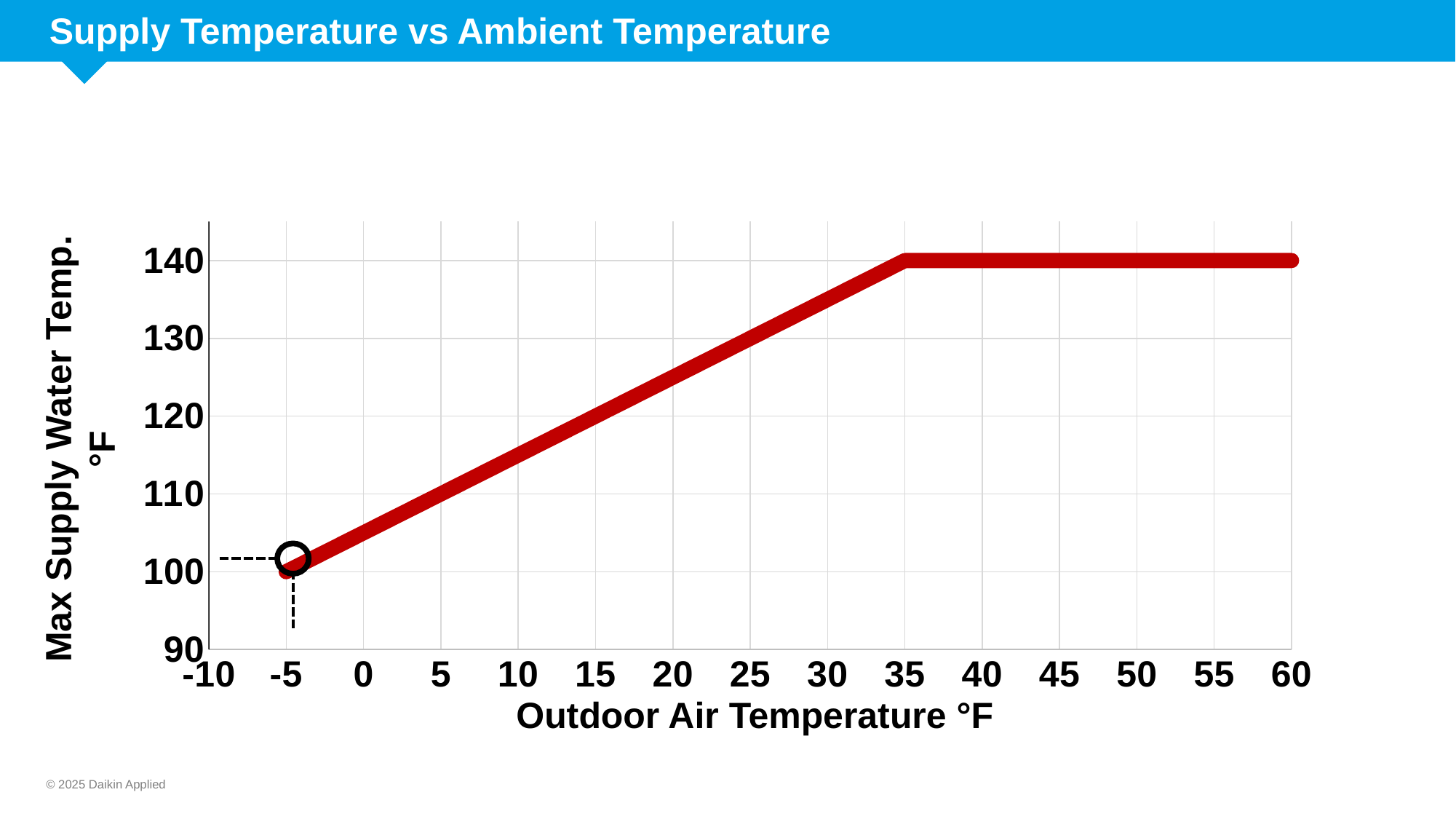
Is the Max Supply Water Temp. at an Outdoor Air Temperature of 5 °F greater or less than 120? less What is the Max Supply Water Temp. at an Outdoor Air Temperature of 35 °F? 140 Is the Max Supply Water Temp. at an Outdoor Air Temperature of 25 °F greater or less than 120? greater What is the Max Supply Water Temp. at an Outdoor Air Temperature of 60 °F? 140 What is the Max Supply Water Temp. at an Outdoor Air Temperature of -5 °F? 100 Does the Max Supply Water Temp. rise or fall as Outdoor Air Temperature increases from -5 to 35 °F? rise What is the difference in Max Supply Water Temp. between an Outdoor Air Temperature of 35 °F and -5 °F? 40 Does the Max Supply Water Temp. rise, fall or stay flat as Outdoor Air Temperature increases from 35 to 60 °F? stay flat What kind of chart is shown on the slide? line chart What is the title of the x axis of the chart? Outdoor Air Temperature °F Is the Max Supply Water Temp. at an Outdoor Air Temperature of 15 °F greater or less than 130? less Which has the larger Max Supply Water Temp.: an Outdoor Air Temperature of 10 °F or 30 °F? 30 °F